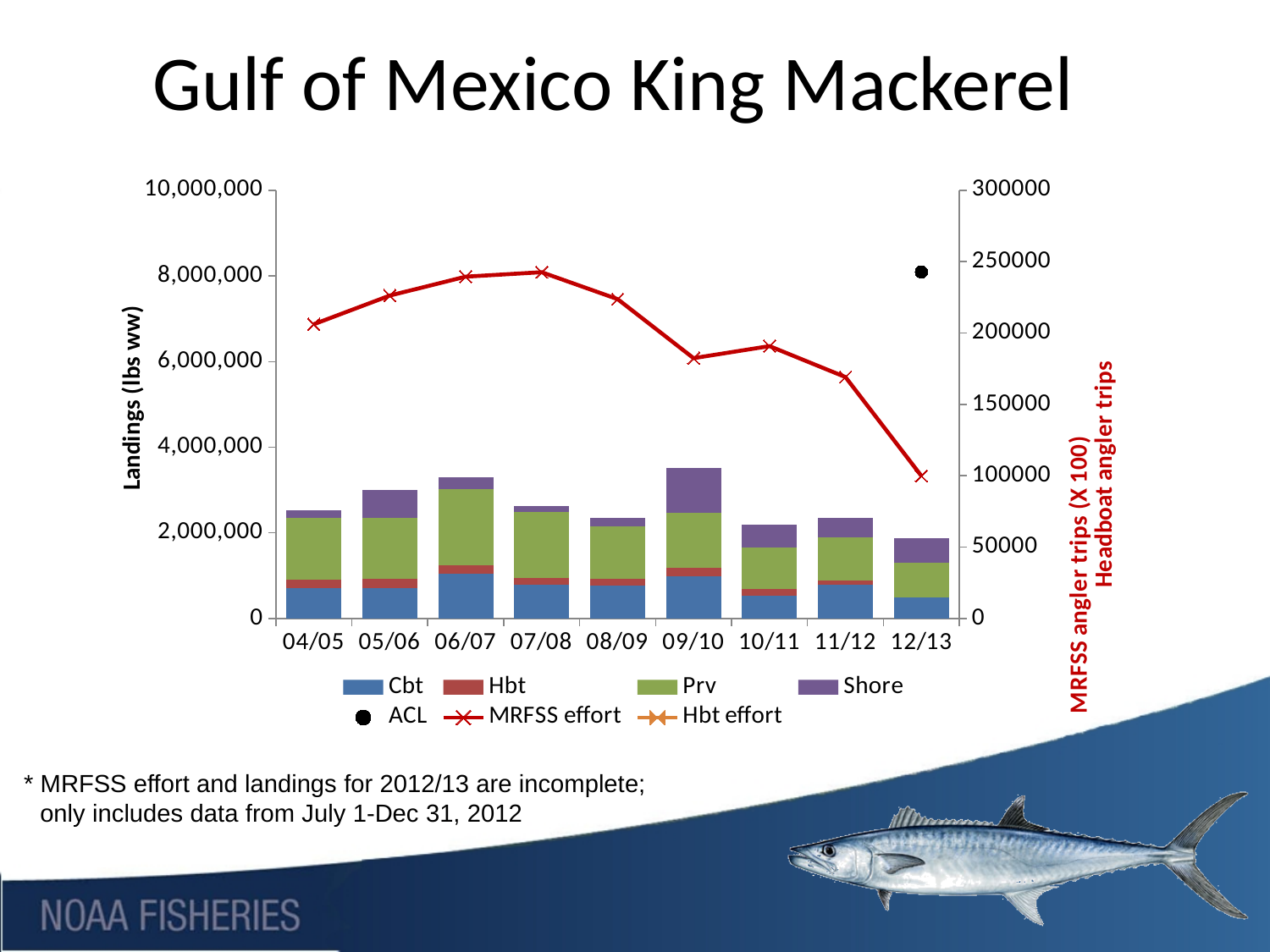
Is the MRFSS effort value for 07/08 greater or less than 200000? greater Which season has the larger total landings bar, 09/10 or 10/11? 09/10 How many entries does the chart's legend list? 7 Is the total landings bar for 09/10 greater or less than 3,000,000? greater Is the total landings bar for 12/13 greater or less than 2,000,000? less How many fishing seasons (categories) are shown on the x axis of the chart? 9 Which season has the lowest total stacked landings bar? 12/13 What is the title of the left vertical axis? Landings (lbs ww) What kind of chart is shown on the slide? Stacked bar chart combined with a line Does the MRFSS effort line rise or fall from 07/08 to 12/13? fall Which season has the lowest MRFSS effort value? 12/13